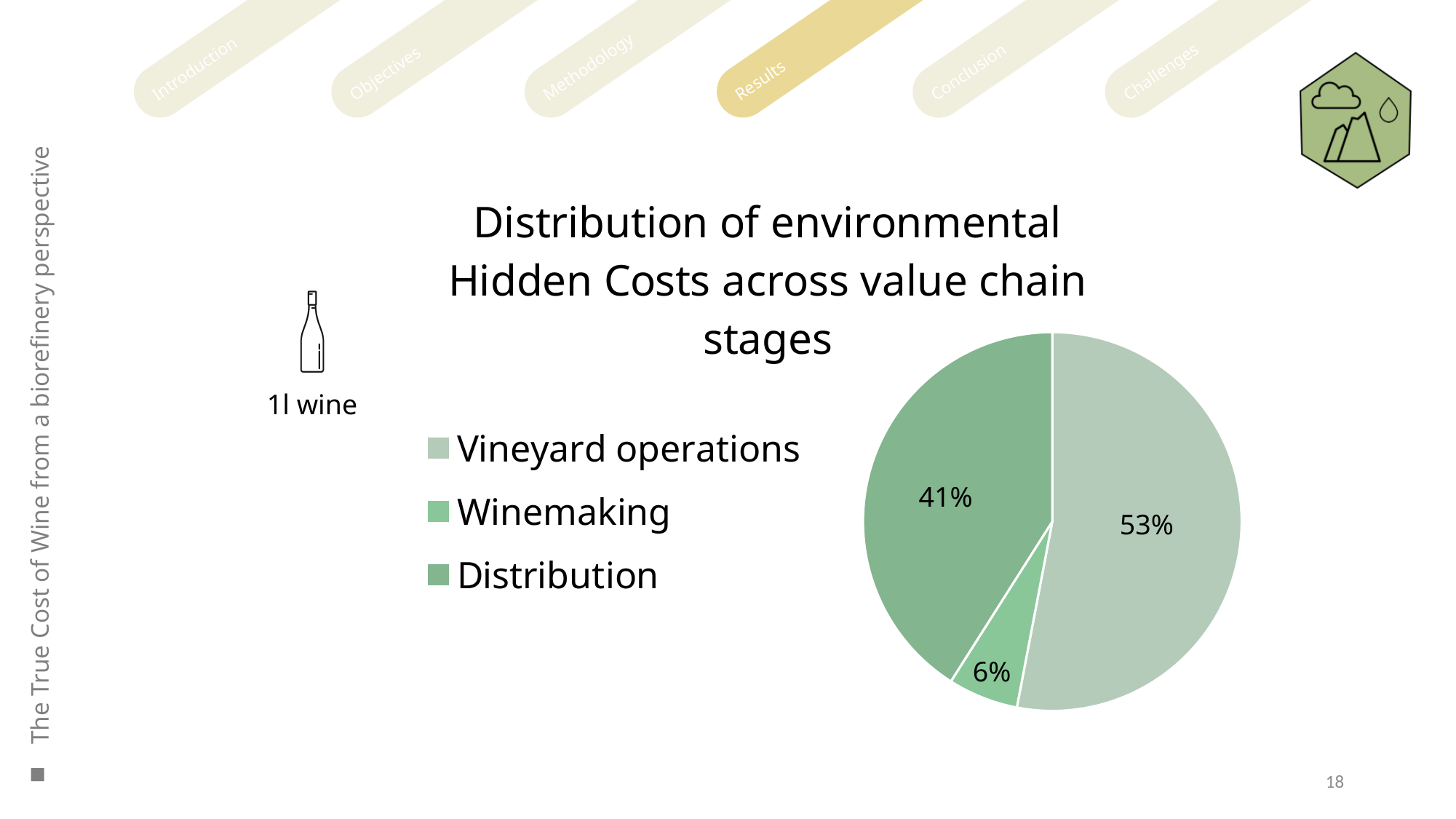
What share of environmental hidden costs comes from Distribution? 41% Which value chain stage has the largest share of environmental hidden costs? Vineyard operations What is the difference in percentage points between the Distribution share and the Winemaking share? 35 What is the difference in percentage points between the Vineyard operations share and the Distribution share? 12 Which value chain stage has the smallest share of environmental hidden costs? Winemaking How many value chain stages are shown in the pie chart? 3 What share of environmental hidden costs comes from Winemaking? 6% What is the title of the chart? Distribution of environmental Hidden Costs across value chain stages What functional unit is indicated next to the bottle icon on the slide? 1l wine What share of environmental hidden costs comes from Vineyard operations? 53% Which has a larger share of environmental hidden costs, Distribution or Winemaking? Distribution What type of chart is used on this slide? Pie chart